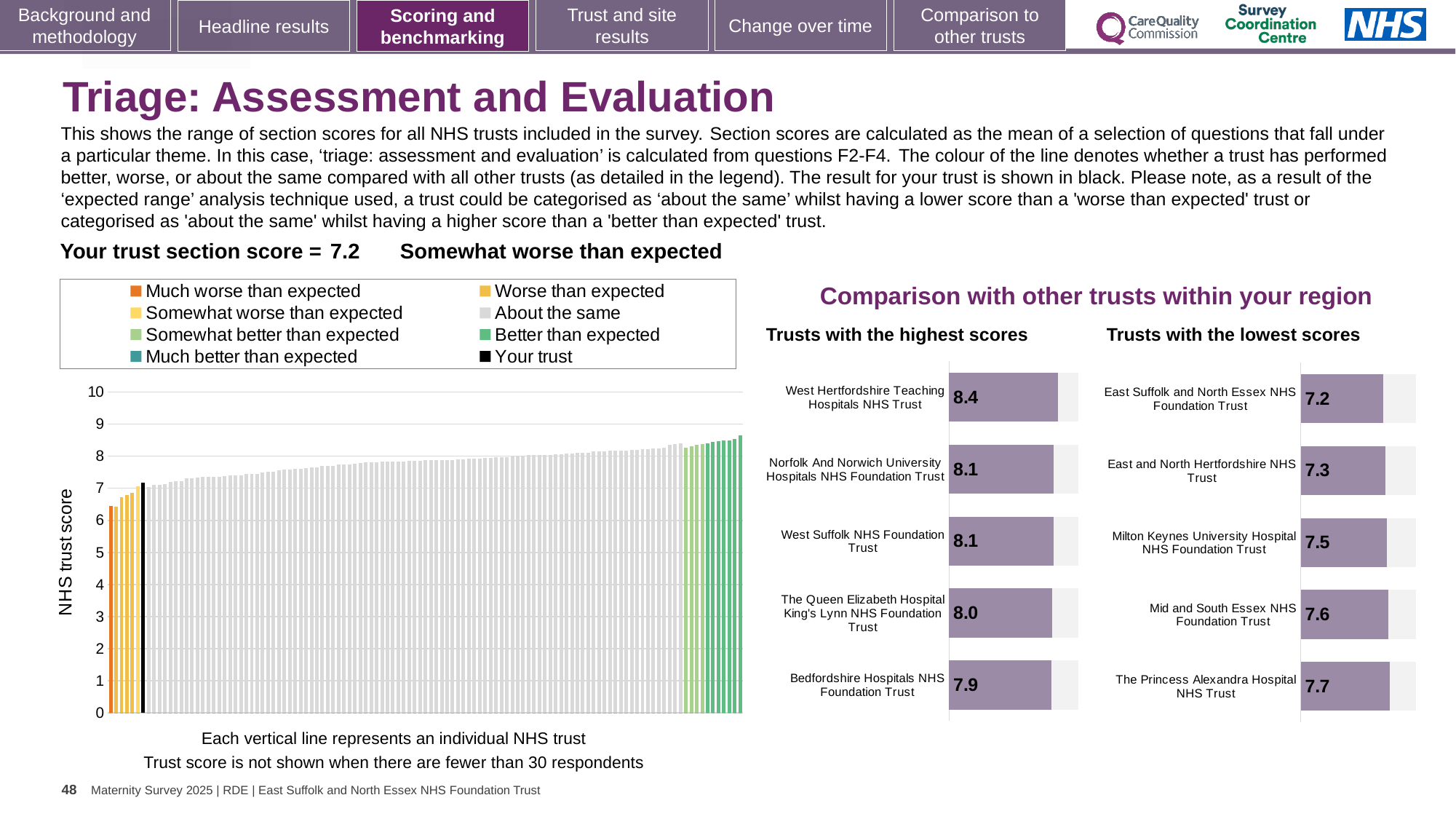
In the 'NHS trust score' chart, is the value of the tallest bar greater or less than 9? less In the 'Trusts with the highest scores' chart, what is the score for West Hertfordshire Teaching Hospitals NHS Trust? 8.4 In the 'Trusts with the lowest scores' chart, which trust has the lowest score? East Suffolk and North Essex NHS Foundation Trust In the 'NHS trust score' chart, do the bars rise or fall from left to right? Rise What kind of chart is the 'NHS trust score' chart on the left? Bar chart In the 'Trusts with the highest scores' chart, which trust has the highest score? West Hertfordshire Teaching Hospitals NHS Trust What is the section score for your trust shown on the slide? 7.2 In the 'Trusts with the lowest scores' chart, what is the score for Milton Keynes University Hospital NHS Foundation Trust? 7.5 In the 'Trusts with the highest scores' chart, what is the difference between the scores of West Hertfordshire Teaching Hospitals NHS Trust and Bedfordshire Hospitals NHS Foundation Trust? 0.5 In the 'Trusts with the lowest scores' chart, which has the higher score: Mid and South Essex NHS Foundation Trust or East and North Hertfordshire NHS Trust? Mid and South Essex NHS Foundation Trust How many trusts are shown in the 'Trusts with the highest scores' chart? 5 How many entries does the legend of the 'NHS trust score' chart list? 8